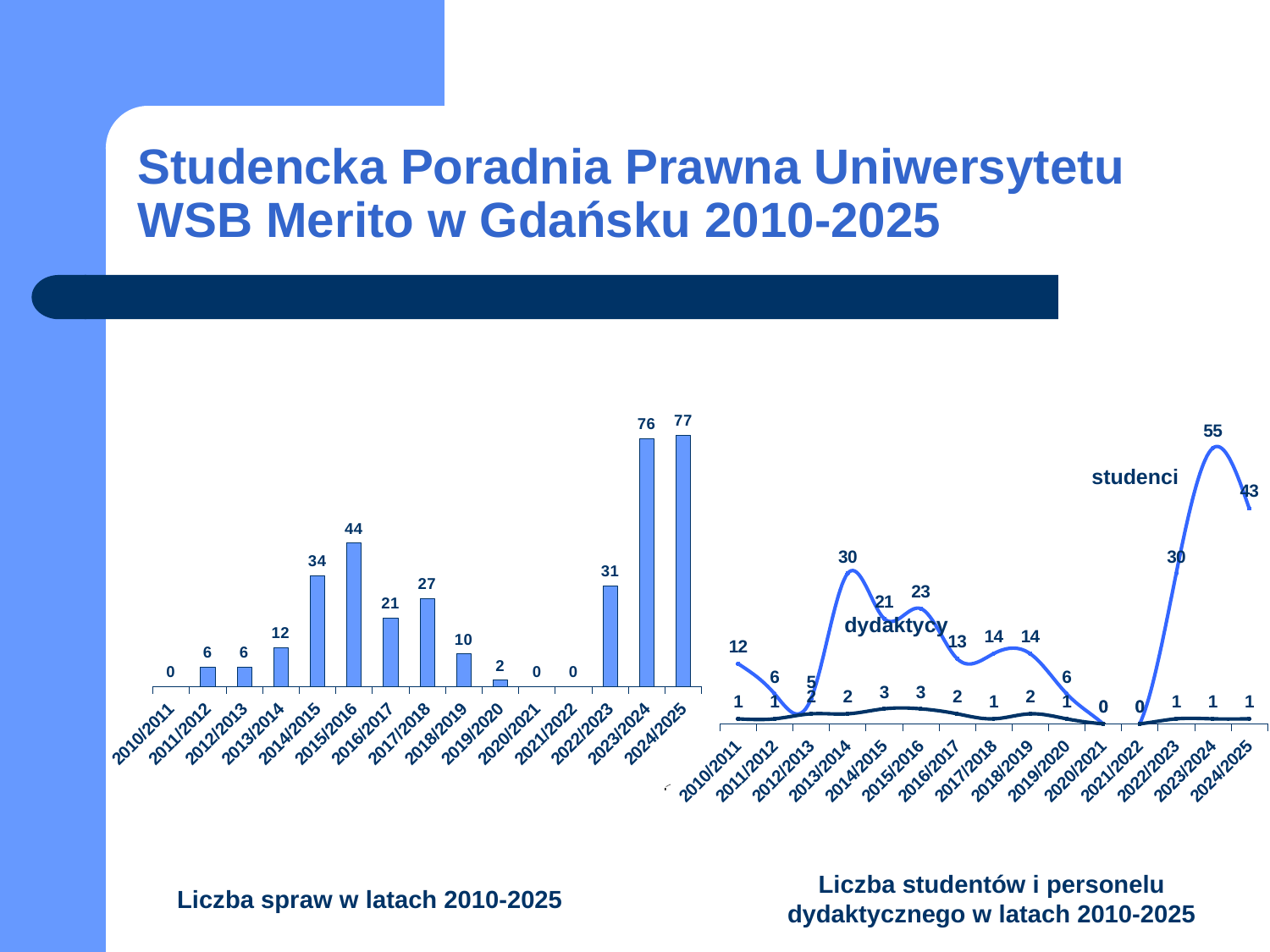
In the chart 'Liczba spraw w latach 2010-2025', what is the difference between the values for 2023/2024 and 2022/2023? 45 What kind of chart is 'Liczba studentów i personelu dydaktycznego w latach 2010-2025'? line chart In the chart 'Liczba studentów i personelu dydaktycznego w latach 2010-2025', what is the value of the 'studenci' series for 2023/2024? 55 How many years are shown on the x axis of the chart 'Liczba spraw w latach 2010-2025'? 15 In the chart 'Liczba studentów i personelu dydaktycznego w latach 2010-2025', what is the difference between the 'studenci' values for 2023/2024 and 2024/2025? 12 In the chart 'Liczba spraw w latach 2010-2025', what is the value for 2015/2016? 44 What kind of chart is 'Liczba spraw w latach 2010-2025'? bar chart How many series are plotted in the chart 'Liczba studentów i personelu dydaktycznego w latach 2010-2025'? 2 In the chart 'Liczba spraw w latach 2010-2025', which is larger, the value for 2014/2015 or the value for 2017/2018? 2014/2015 In the chart 'Liczba studentów i personelu dydaktycznego w latach 2010-2025', what is the value of the 'dydaktycy' series for 2014/2015? 3 In the chart 'Liczba studentów i personelu dydaktycznego w latach 2010-2025', does the 'studenci' series rise or fall from 2021/2022 to 2023/2024? rise In the chart 'Liczba spraw w latach 2010-2025', which year has the highest value? 2024/2025